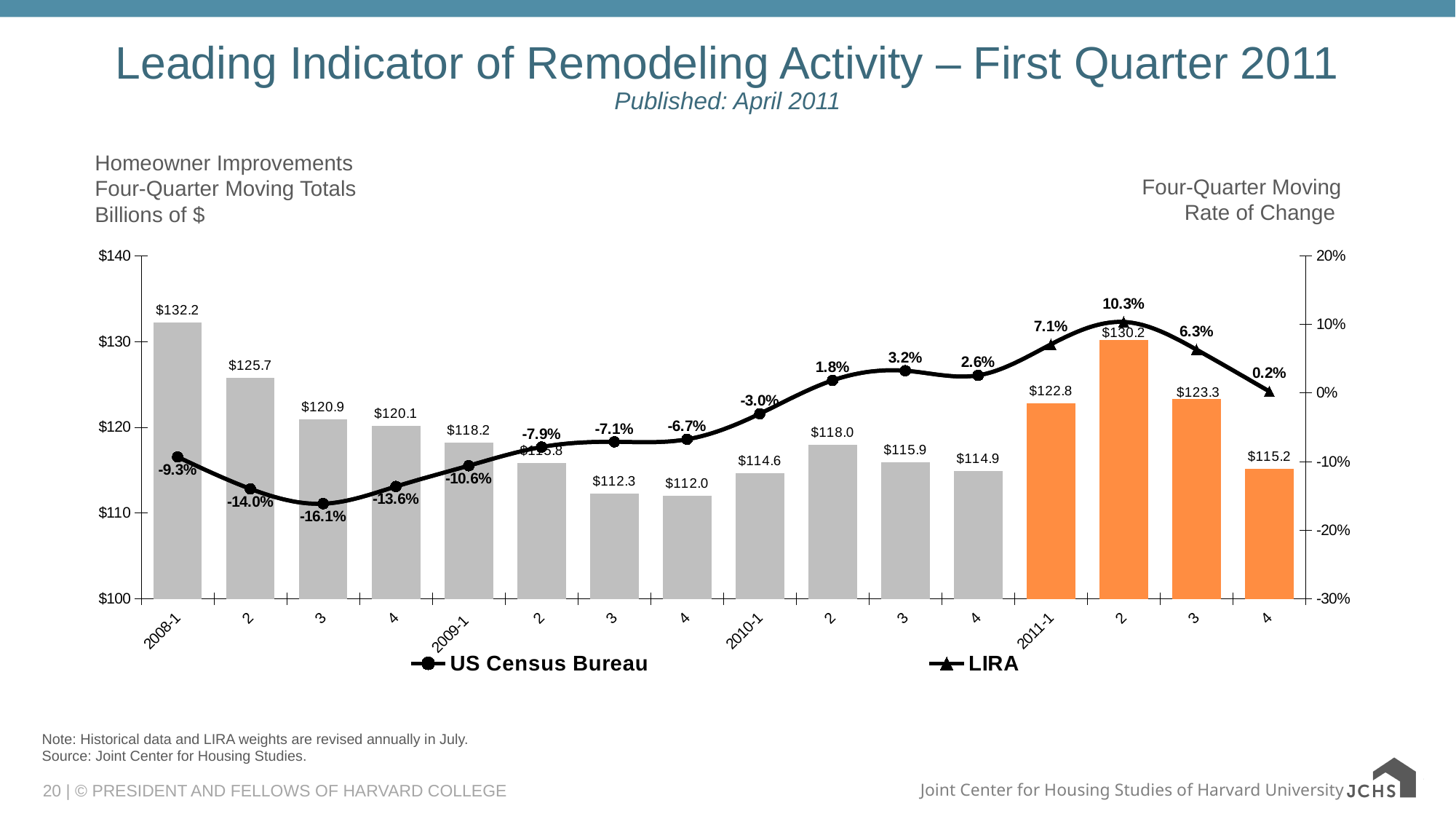
What is the four-quarter moving rate of change for 2010-1? -3.0% Which quarter has the lowest four-quarter moving total bar? 2009-4 Which has the larger four-quarter moving total, 2010-2 or 2010-3? 2010-2 What is the four-quarter moving rate of change for 2011-2? 10.3% Which quarter has the highest four-quarter moving total bar? 2008-1 What is the difference between the four-quarter moving totals for 2011-2 and 2011-1? $7.4 Which quarter has the lowest four-quarter moving rate of change? 2008-3 How many series does the legend list? 2 How many quarters (bars) are plotted on the chart? 16 What kind of chart is shown on the slide? Combination bar and line chart What is the four-quarter moving total for 2008-1? $132.2